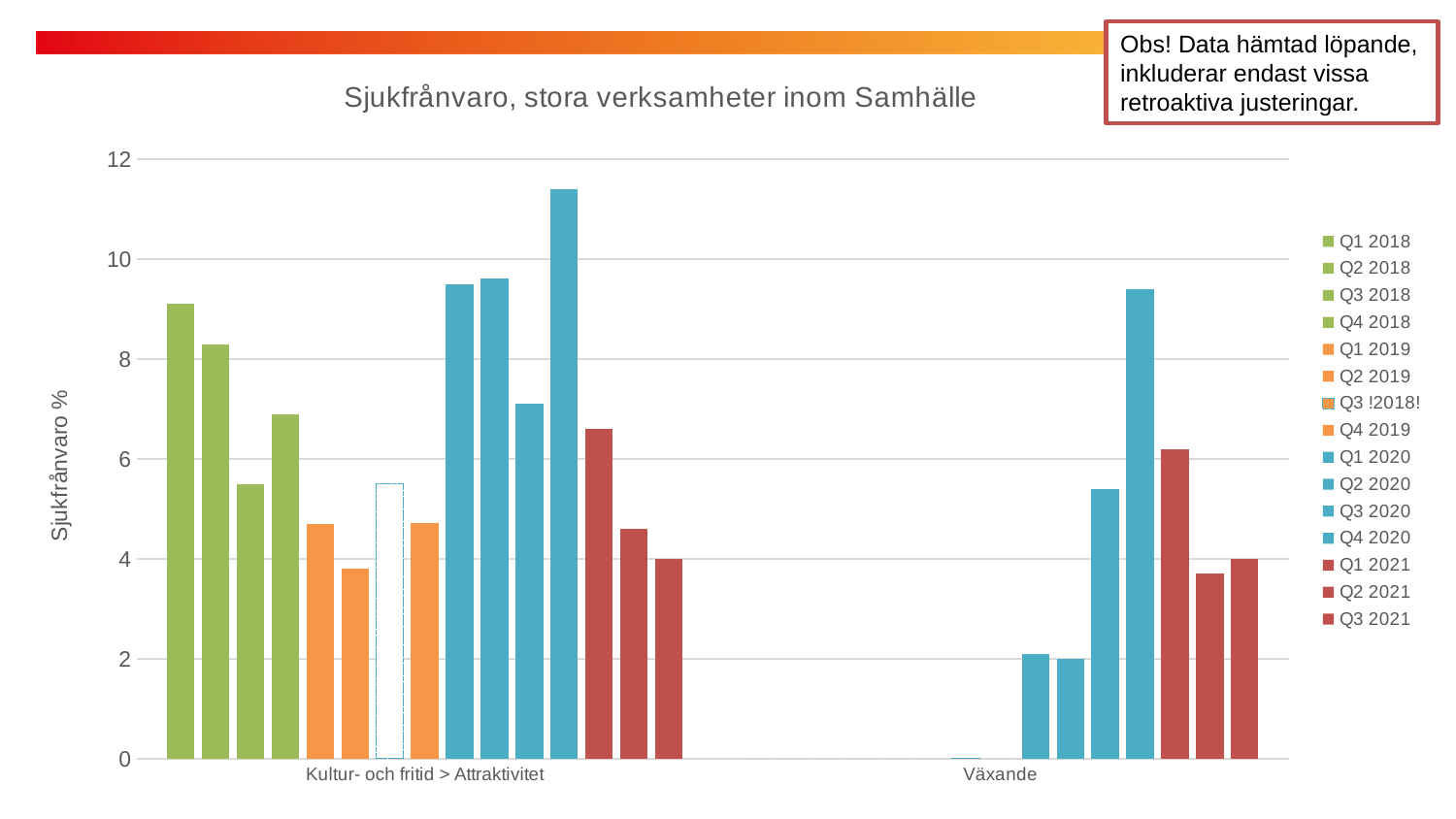
In Kultur- och fritid > Attraktivitet, which is larger: the value for Q1 2018 or the value for Q2 2019? Q1 2018 How many categories are shown on the x axis of the chart? 2 For the category Kultur- och fritid > Attraktivitet, which series has the highest value? Q4 2020 In Växande, which is larger: the value for Q4 2020 or the value for Q1 2021? Q4 2020 What kind of chart is shown on the slide? bar chart Is the value for Q4 2020 in Kultur- och fritid > Attraktivitet greater or less than 10? greater How many series does the legend list? 15 Is the value for Q1 2018 in Kultur- och fritid > Attraktivitet greater or less than 8? greater What is the title of the chart? Sjukfrånvaro, stora verksamheter inom Samhälle For the category Växande, which series has the highest value? Q4 2020 Is the value for Q3 2020 in Växande greater or less than 6? less